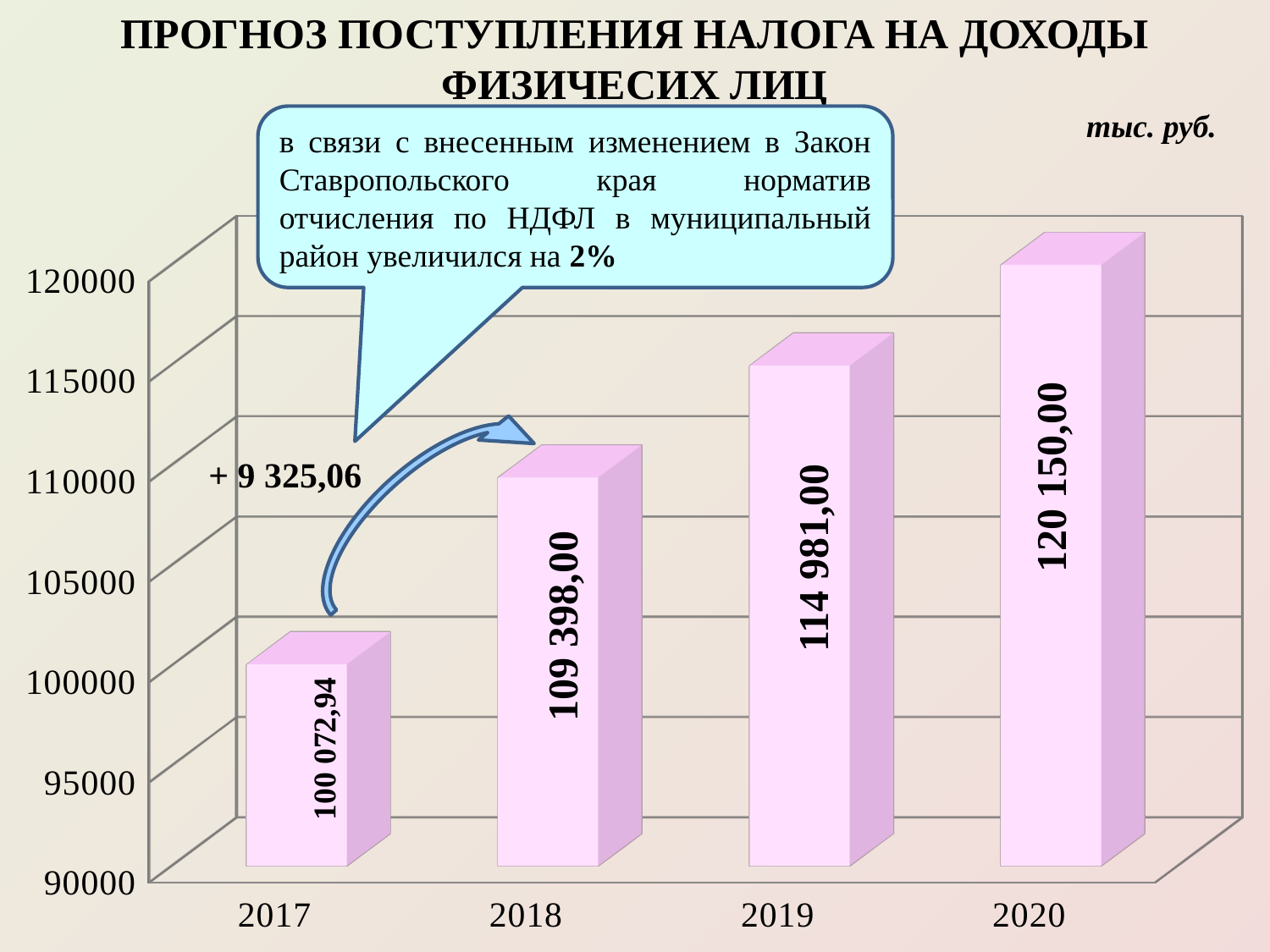
What is the difference between the 2018 and 2017 values? 9 325,06 What type of chart is shown on the slide? bar chart Which year has the highest forecast value? 2020 Which is larger, the value for 2019 or the value for 2018? 2019 What is the difference between the 2019 and 2018 values? 5 583,00 What is the forecast value for 2018? 109 398,00 What is the forecast value for 2017? 100 072,94 How many years are shown on the chart? 4 What is the forecast value for 2020? 120 150,00 What is the forecast value for 2019? 114 981,00 Which year has the lowest forecast value? 2017 Do the values rise or fall from 2017 to 2020? rise